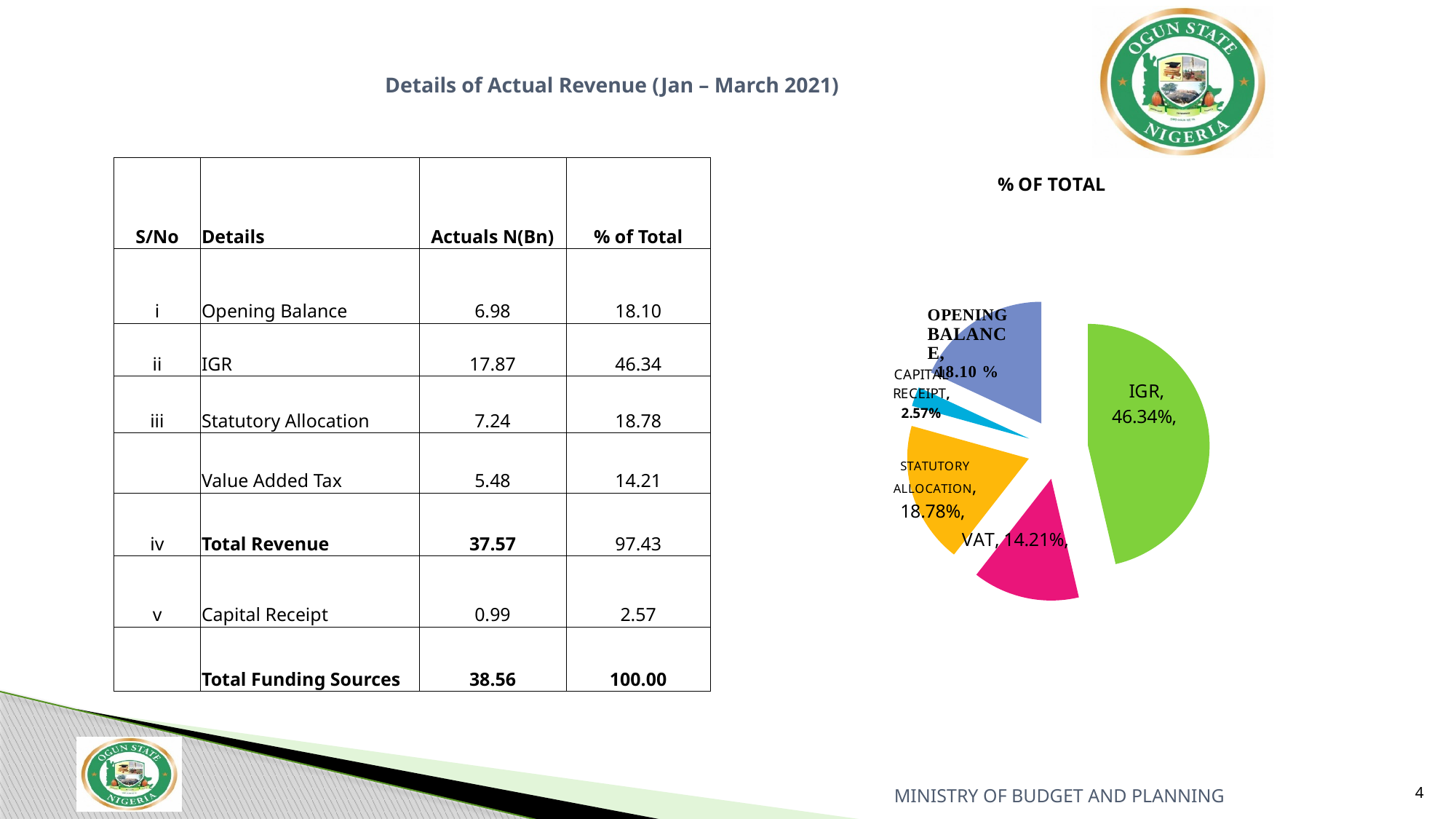
Which slice of the pie chart is the smallest? Capital Receipt What colour is the IGR slice in the pie chart? green What is the title of the chart? % OF TOTAL Which slice of the pie chart is the largest? IGR Which is larger in the pie chart, Statutory Allocation or VAT? Statutory Allocation What is the value shown for Statutory Allocation in the pie chart? 18.78% What kind of chart is shown on the slide? pie chart How many slices does the pie chart have? 5 What is the difference between the IGR share and the VAT share in the pie chart? 32.13% What is the value shown for Capital Receipt in the pie chart? 2.57% What share of the pie does IGR represent? 46.34% What is the value shown for VAT in the pie chart? 14.21%